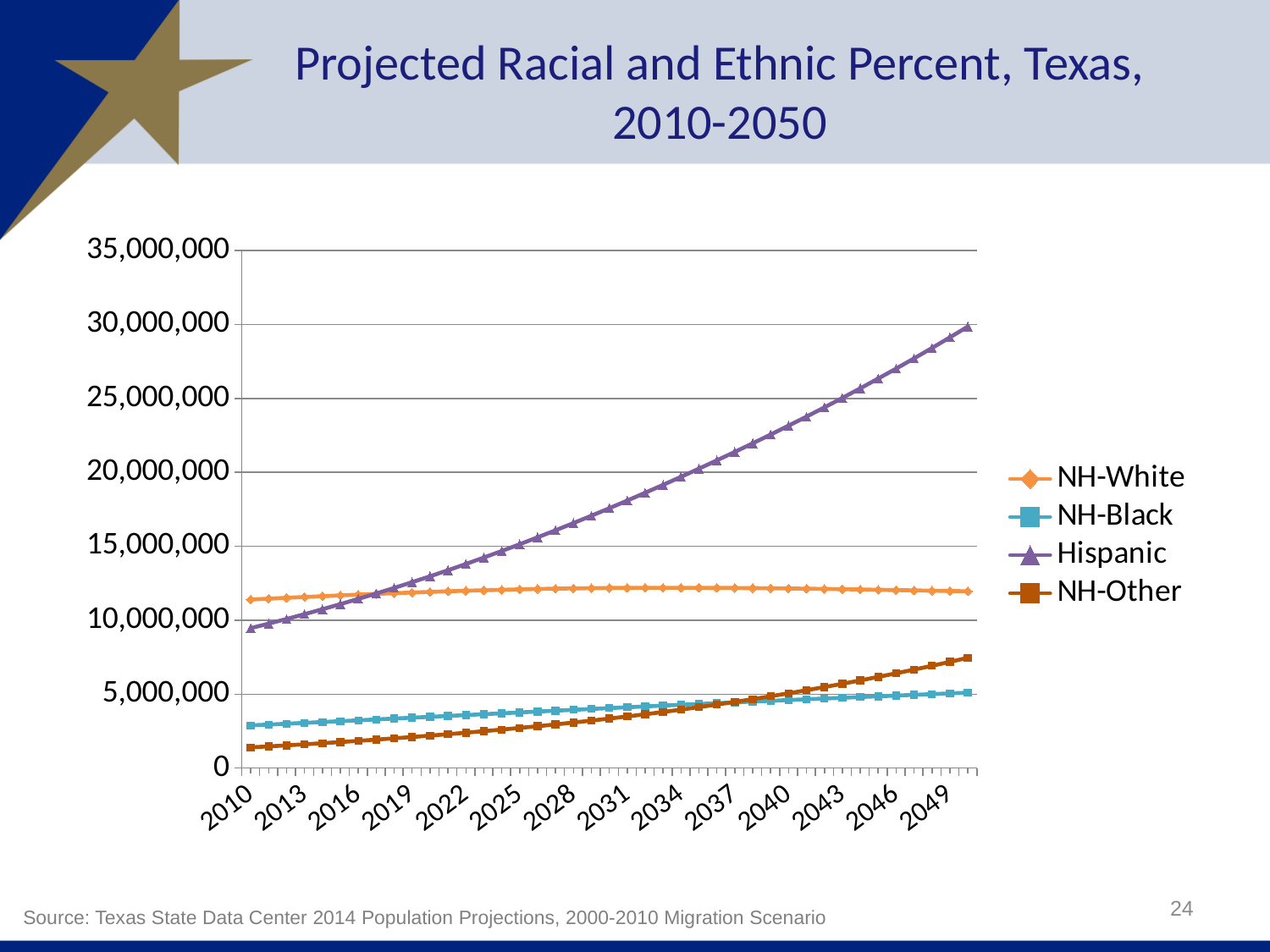
Which series has the highest value in 2010? NH-White Is the value for NH-Other in 2049 greater or less than 5,000,000? greater What kind of chart is shown on the slide? Line chart What are the series names listed in the legend? NH-White, NH-Black, Hispanic, NH-Other Is the value for Hispanic in 2049 greater or less than 25,000,000? greater Is the value for NH-Black in 2010 greater or less than 5,000,000? less Which series has the highest value in 2049? Hispanic What is the title of the chart? Projected Racial and Ethnic Percent, Texas, 2010-2050 How many series does the legend list? 4 In 2049, which is larger: NH-Other or NH-Black? NH-Other Does the Hispanic series rise or fall from 2010 to 2049? Rise Which series has the lowest value in 2010? NH-Other